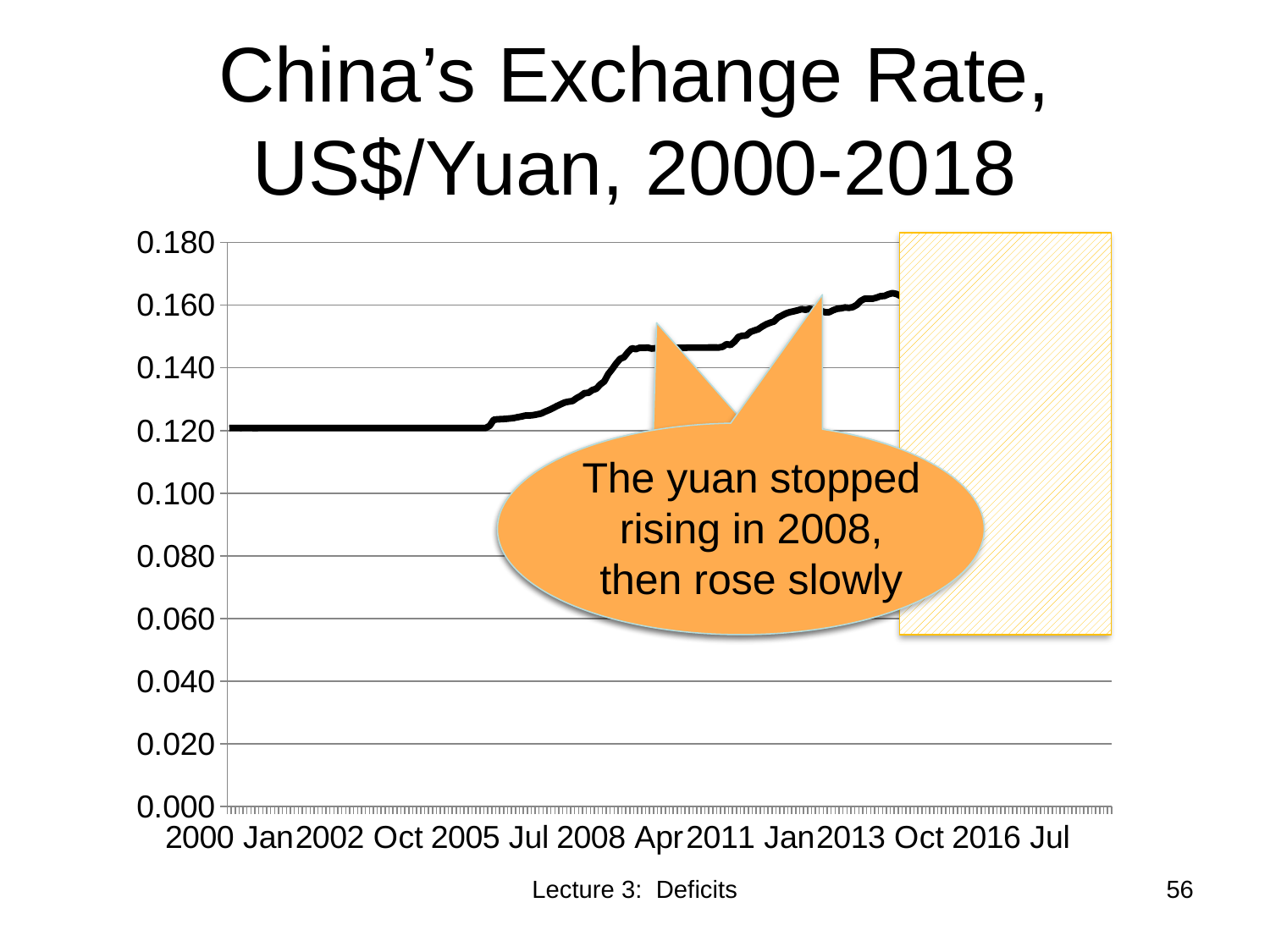
Is the value for 2011 Jan greater or less than 0.120? greater Is the value for 2000 Jan greater or less than 0.140? less Is the value for 2013 Oct larger or smaller than the value for 2000 Jan? larger What is the highest tick value shown on the y axis? 0.180 What is the title of the chart? China's Exchange Rate, US$/Yuan, 2000-2018 What kind of chart is shown on the slide? line chart Is the value for 2000 Jan greater or less than 0.100? greater Overall, does the exchange rate rise or fall from 2000 Jan to the end of the series? rise Between 2000 Jan and 2005 Jul, does the line rise, fall, or stay flat? stay flat How many date labels are shown on the x axis? 7